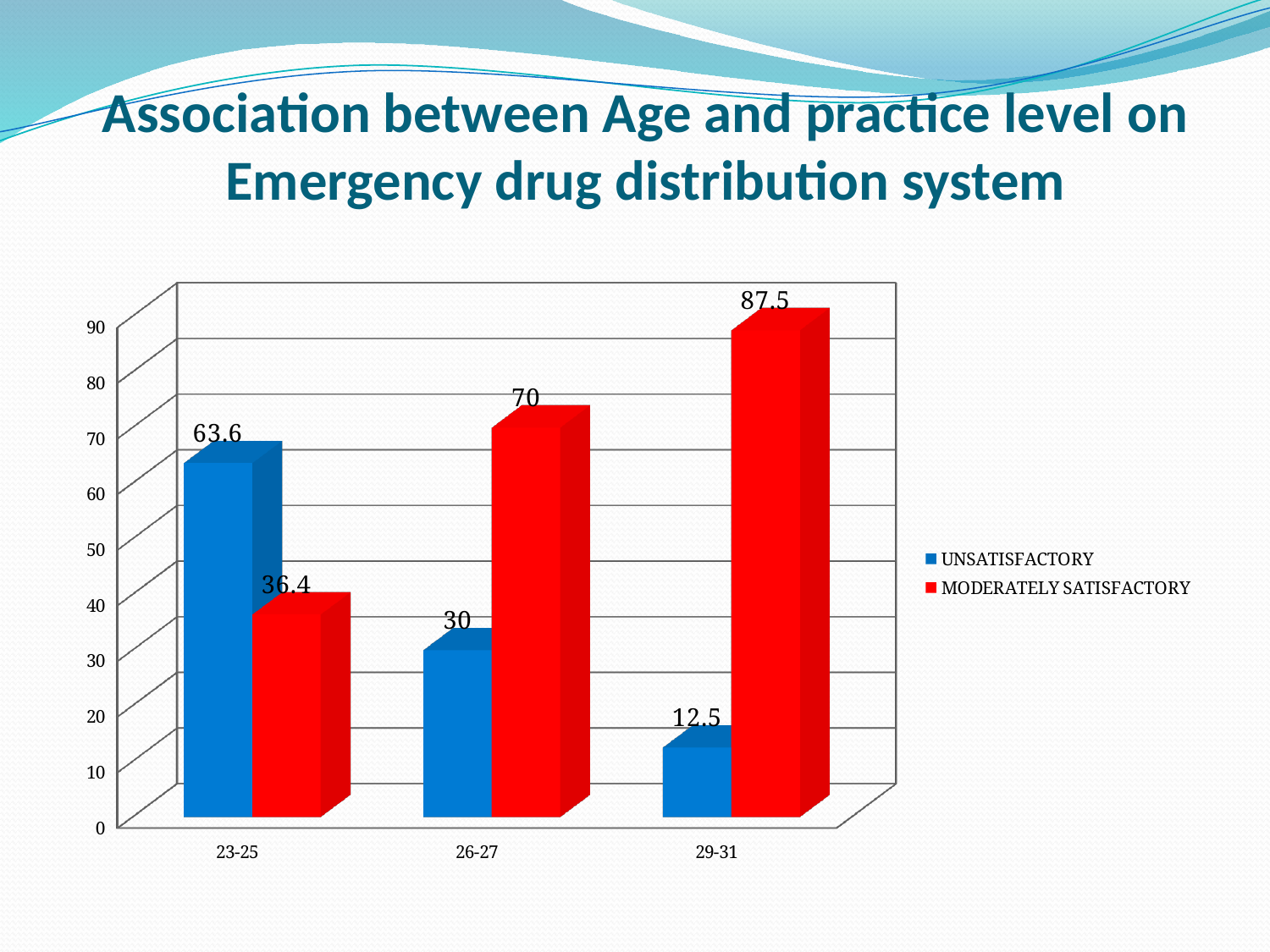
Do the UNSATISFACTORY values rise or fall from the 23-25 group to the 29-31 group? Fall What is the UNSATISFACTORY value for the 23-25 age group? 63.6 Which age group has the lowest UNSATISFACTORY value? 29-31 For the 23-25 age group, which is larger: UNSATISFACTORY or MODERATELY SATISFACTORY? UNSATISFACTORY How many series does the legend list? 2 What is the MODERATELY SATISFACTORY value for the 26-27 age group? 70 What kind of chart is shown on the slide? Bar chart What is the difference between the MODERATELY SATISFACTORY and UNSATISFACTORY values for the 29-31 age group? 75 What is the MODERATELY SATISFACTORY value for the 29-31 age group? 87.5 Which age group has the highest MODERATELY SATISFACTORY value? 29-31 How many age groups are shown on the x axis? 3 What is the UNSATISFACTORY value for the 29-31 age group? 12.5